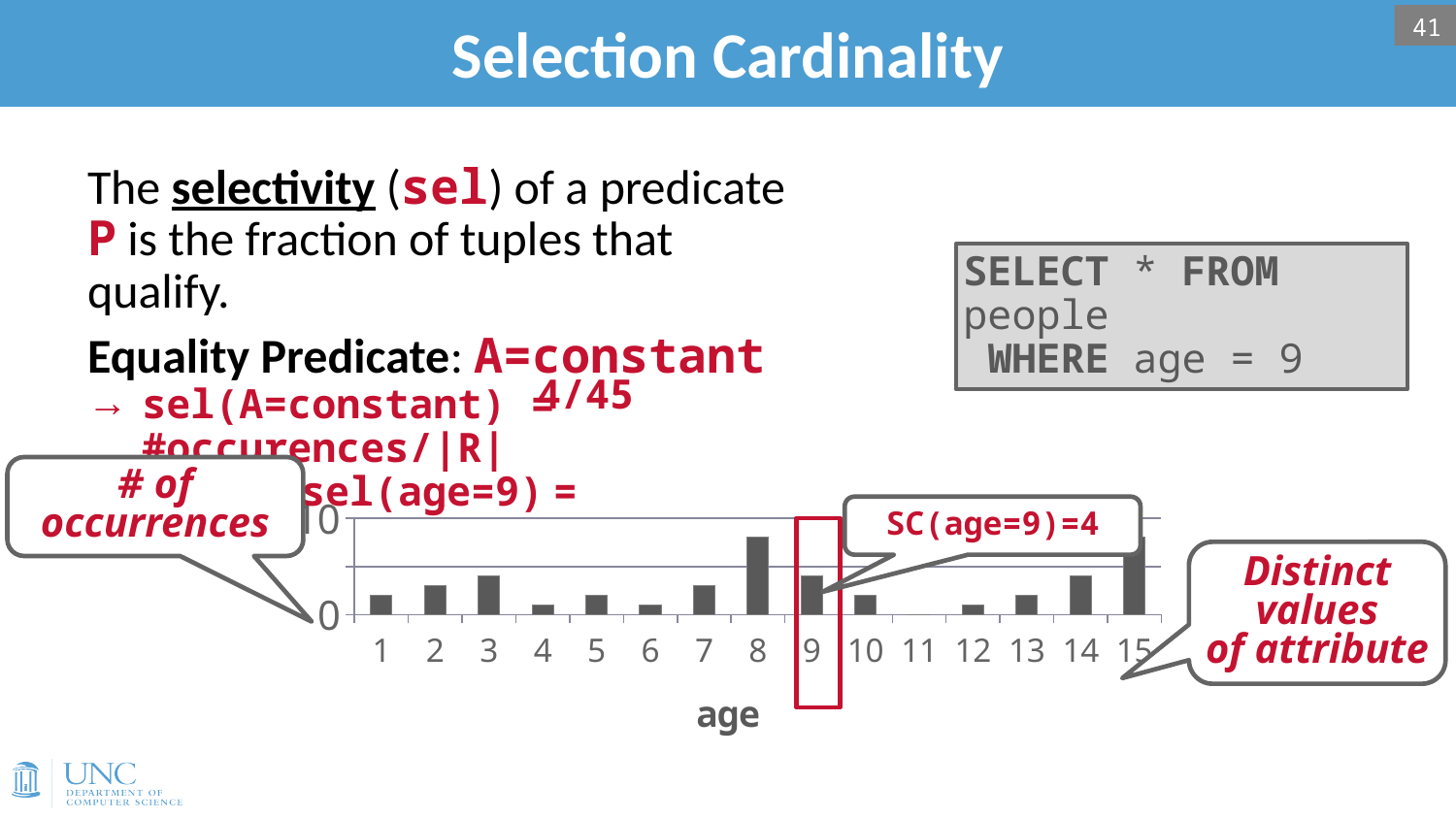
Which is larger in the chart, the bar for age 3 or the bar for age 4? age 3 Is the value for age 8 greater or less than 5? greater What is the highest tick value shown on the y axis of the chart? 10 Is the value for age 4 greater or less than 5? less How many age categories are shown on the x axis of the chart? 15 Which is larger in the chart, the bar for age 8 or the bar for age 9? age 8 Is the value for age 9 greater or less than 5? less Which age has the highest bar in the chart? 8 and 15 (tied) What is the label of the x axis of the chart? age What kind of chart is shown on the slide? bar chart What is the number of occurrences for age 9 in the chart? 4